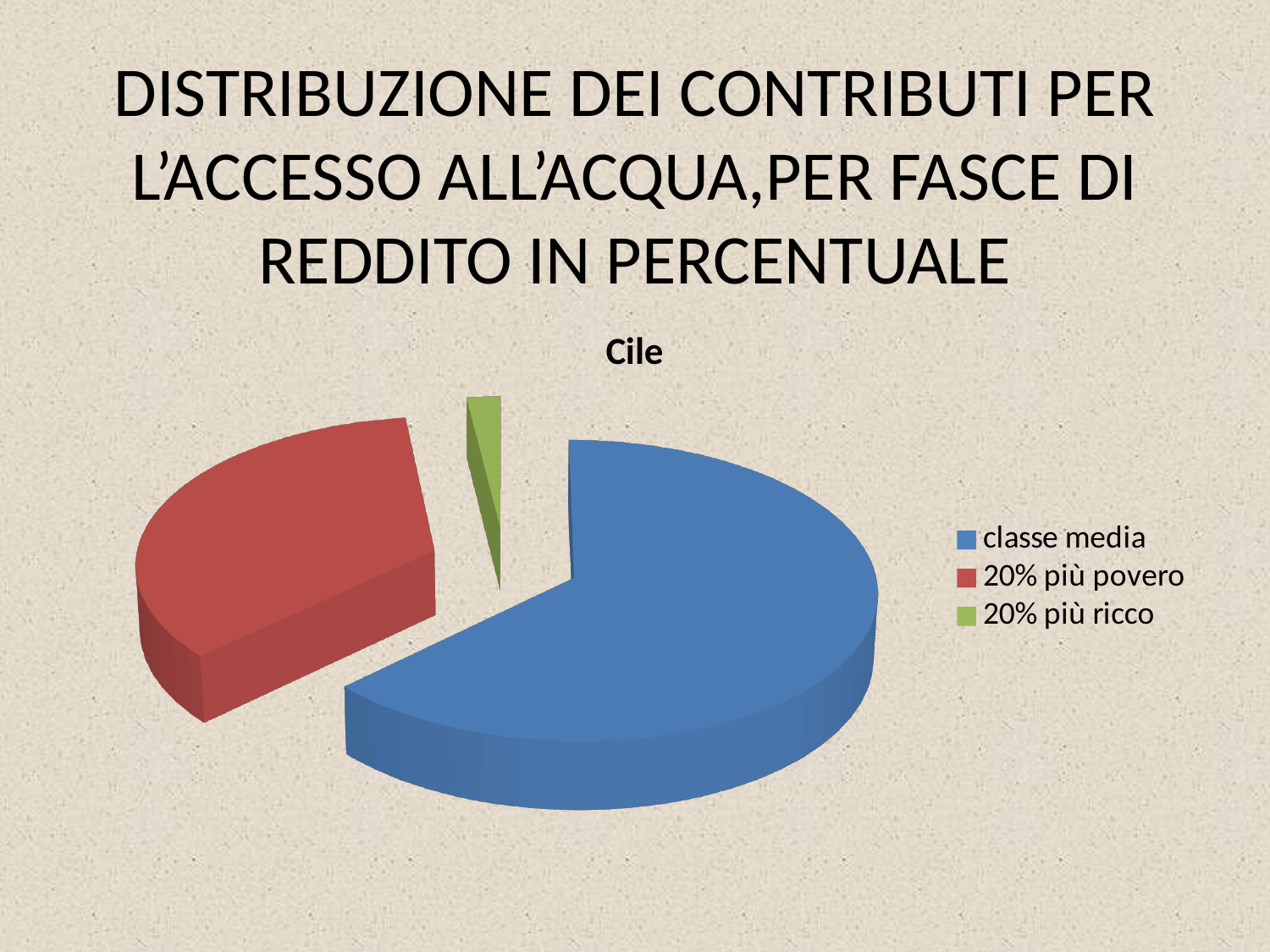
Which slice is larger, '20% più povero' or '20% più ricco'? 20% più povero What kind of chart is shown on the slide? pie chart How many categories does the legend list? 3 Which category is shown in red? 20% più povero Which category has the smallest slice of the pie? 20% più ricco Which category has the largest slice of the pie? classe media Which slice is larger, 'classe media' or '20% più povero'? classe media What is the title of the chart? Cile What colour is the slice for 'classe media'? blue